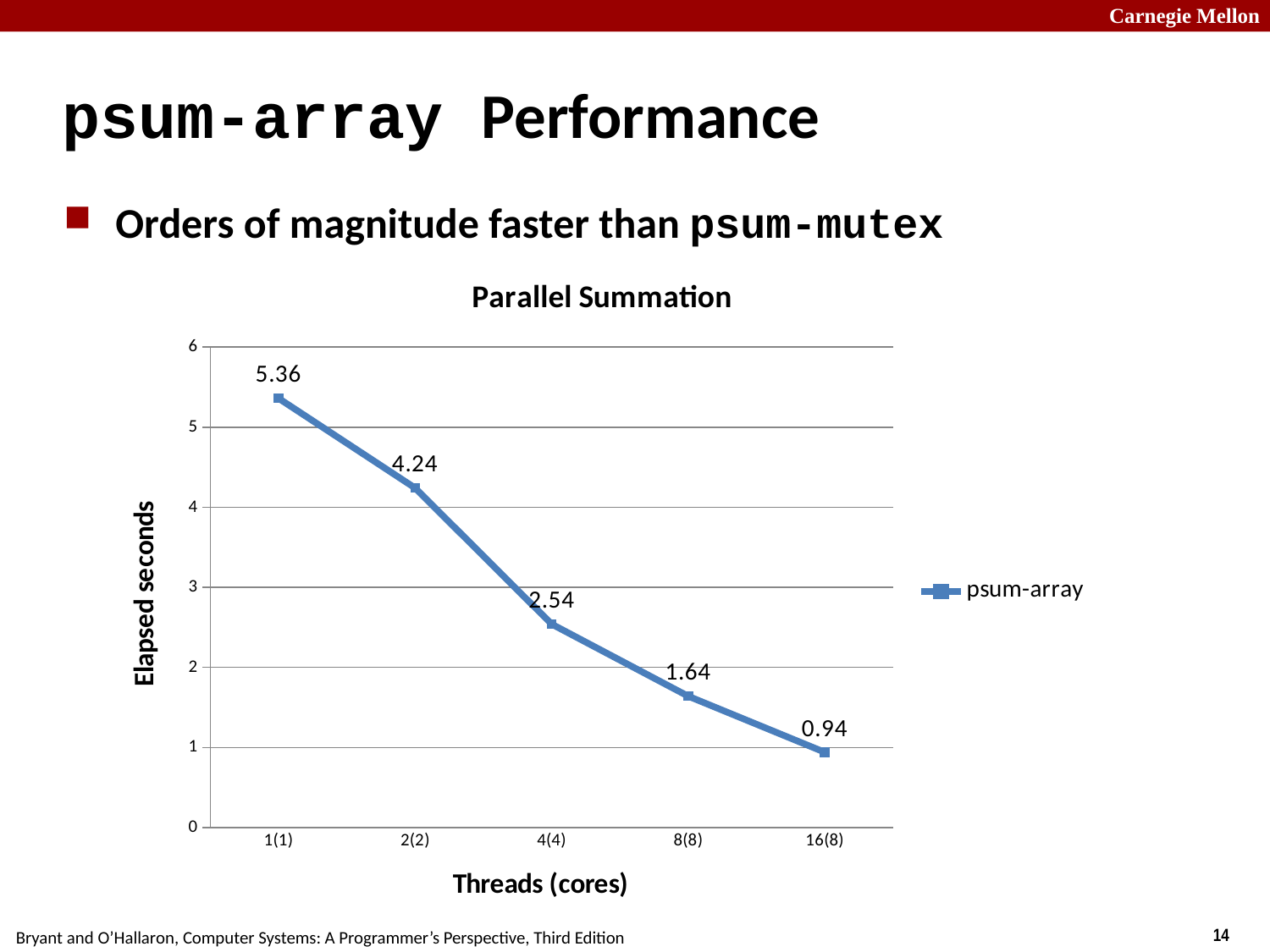
Do the elapsed seconds values rise or fall as the number of threads (cores) increases? fall What is the elapsed seconds value for 16(8) threads (cores)? 0.94 How many threads (cores) settings are plotted on the chart? 5 Which threads (cores) setting has the highest elapsed seconds? 1(1) Which threads (cores) setting has the lowest elapsed seconds? 16(8) Is the elapsed seconds value for 2(2) threads (cores) greater or less than 4? greater What is the difference in elapsed seconds between 2(2) and 8(8) threads (cores)? 2.6 Which has a larger elapsed seconds value, 4(4) or 8(8) threads (cores)? 4(4) What is the elapsed seconds value for 1(1) threads (cores)? 5.36 How many series does the legend list? 1 What is the elapsed seconds value for 4(4) threads (cores)? 2.54 What kind of chart is shown on the slide? line chart